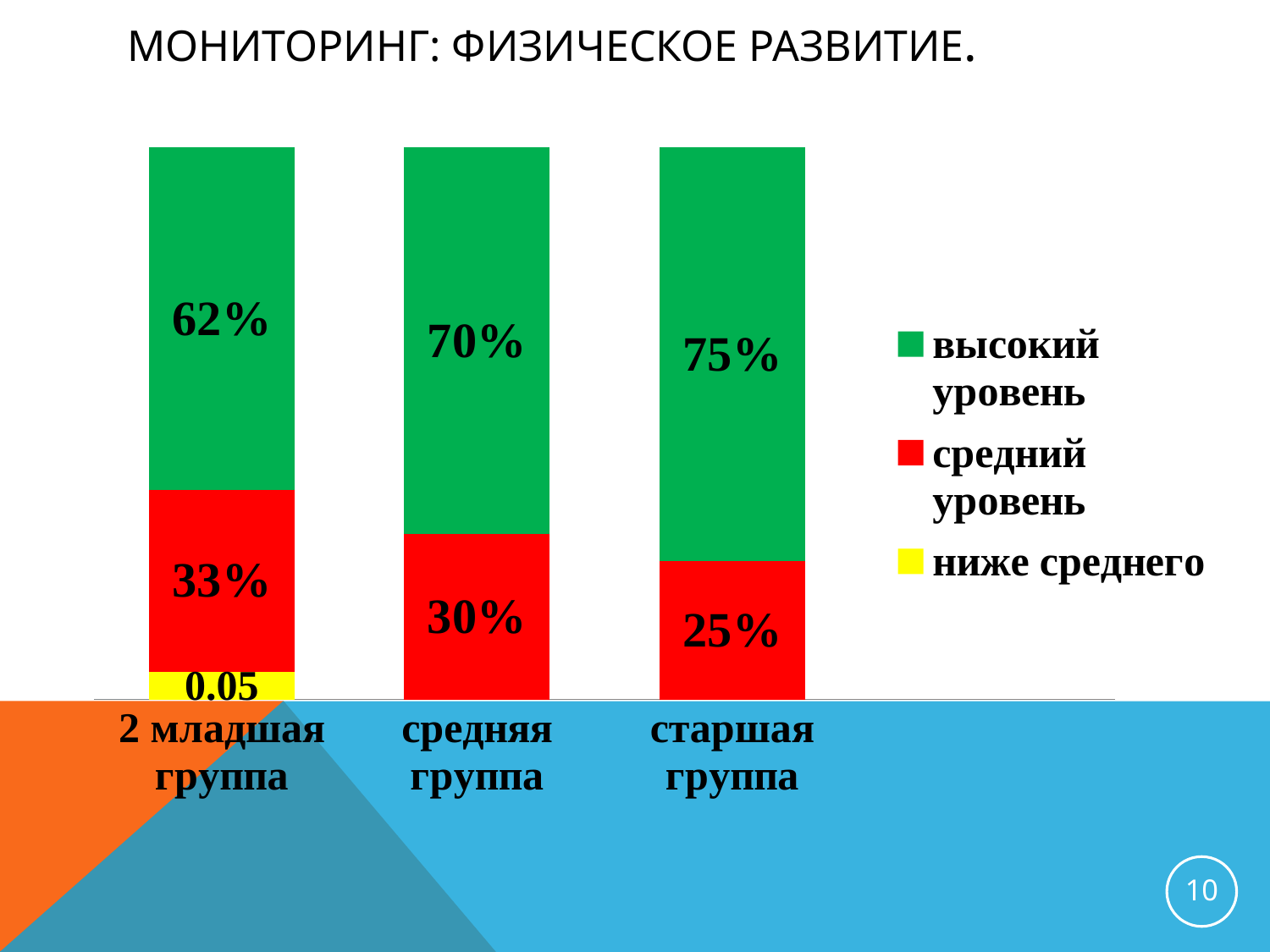
Which is larger: "средний уровень" for "2 младшая группа" or for "средняя группа"? 2 младшая группа What is the value of "высокий уровень" for "старшая группа"? 75% What is the value of "ниже среднего" for "2 младшая группа"? 0.05 Does the value of "высокий уровень" rise or fall from "2 младшая группа" to "старшая группа"? rise How many groups are shown on the x axis? 3 Which group has the highest value for "высокий уровень"? старшая группа Which group has the lowest value for "средний уровень"? старшая группа What is the value of "средний уровень" for "2 младшая группа"? 33% How many series does the legend list? 3 What type of chart is shown on the slide? stacked bar chart What is the difference between the "высокий уровень" values for "старшая группа" and "2 младшая группа"? 13% What is the value of "высокий уровень" for "средняя группа"? 70%